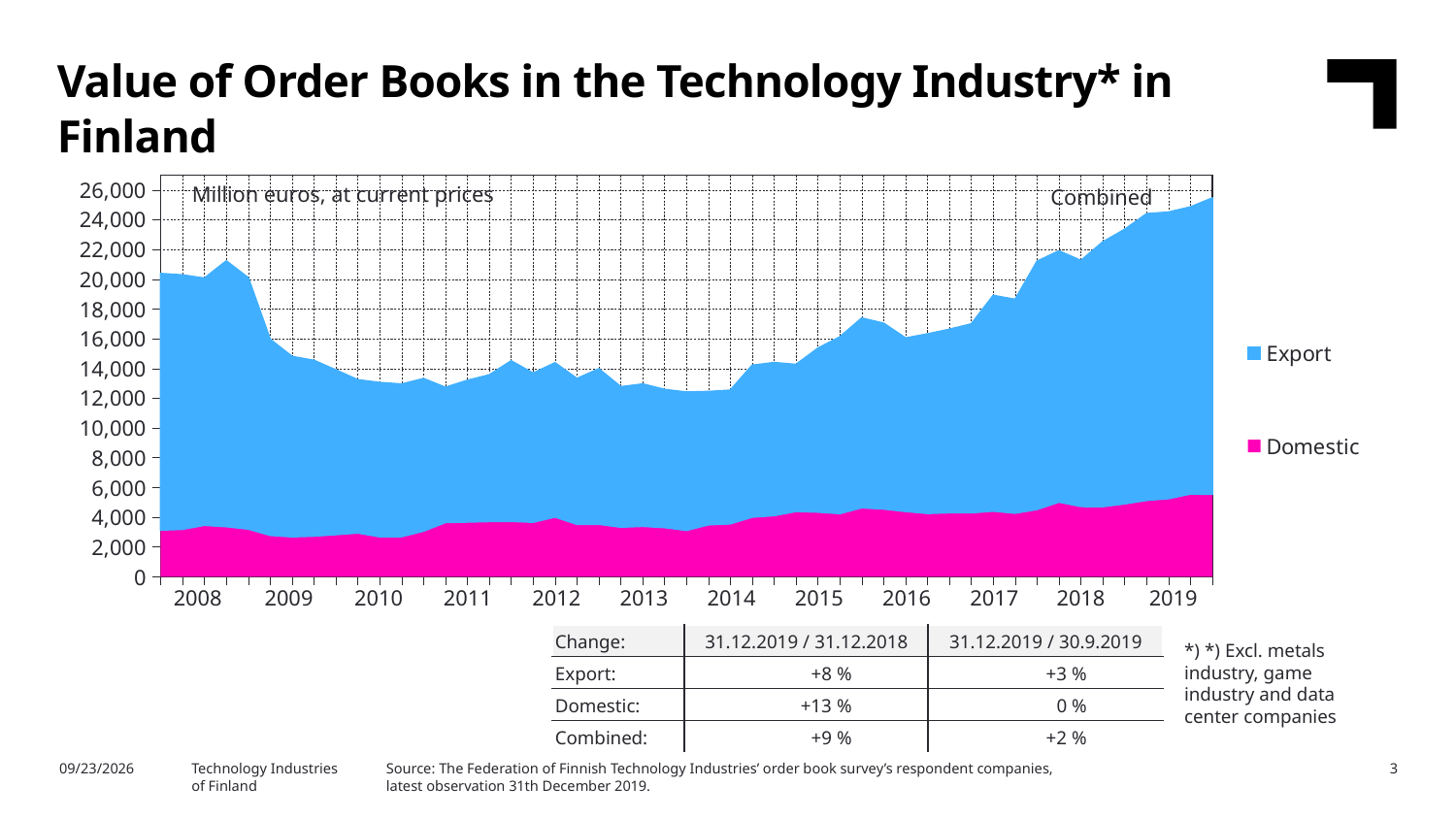
How many years are labelled on the x axis of the chart? 12 Is the combined value of order books at the start of 2008 greater or less than 18,000? greater What unit label is printed inside the chart area at the top left? Million euros, at current prices How many series does the chart legend list? 2 Is the Domestic value at the end of 2019 greater or less than 4,000? greater Does the combined value of order books rise or fall from 2014 to 2019? rise What are the two series named in the chart legend? Export and Domestic Is the Domestic value in 2010 greater or less than 4,000? less What kind of chart is shown on the slide? Stacked area chart Which series is larger in 2019, Export or Domestic? Export